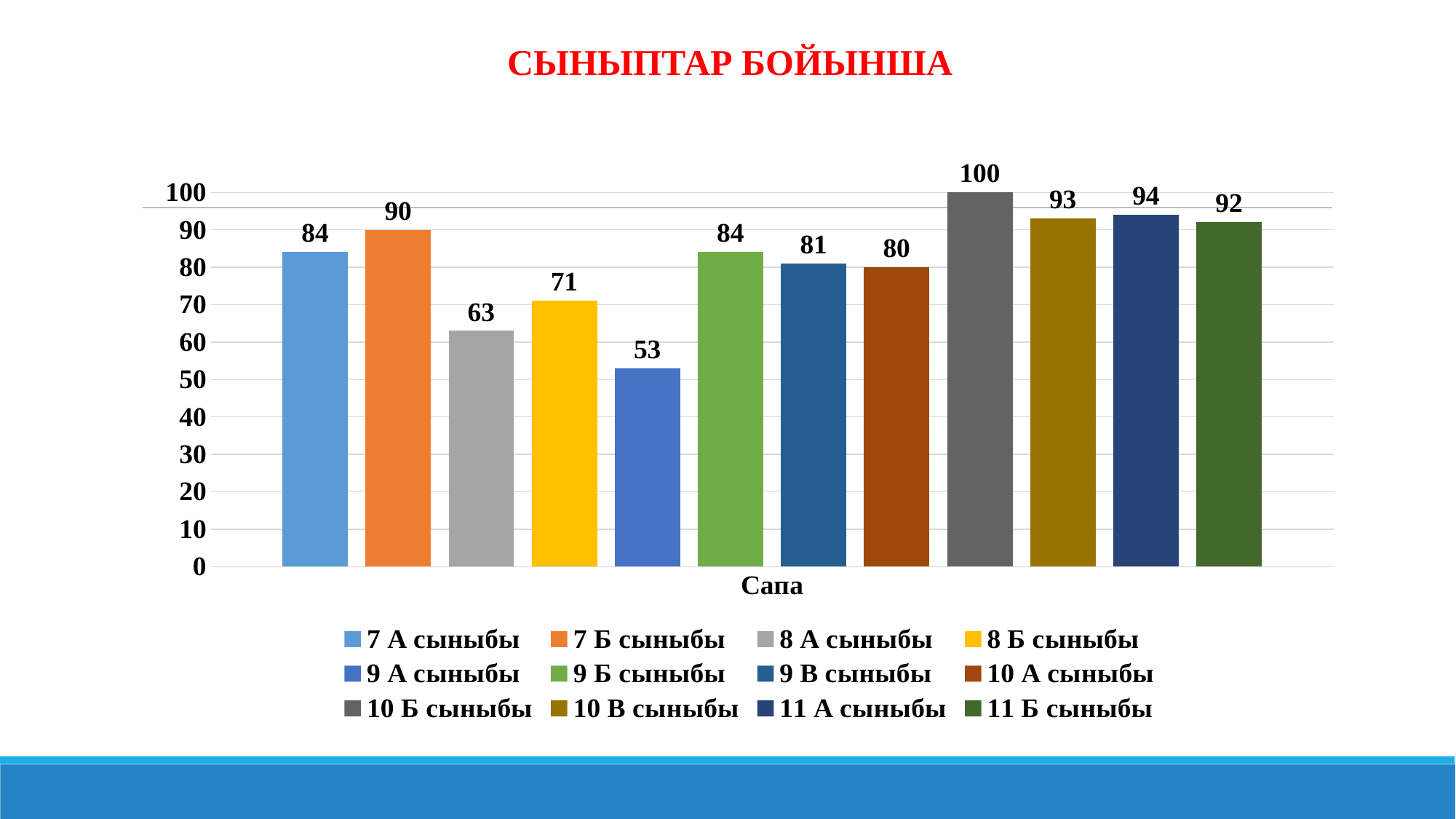
What is the value for 10 В сыныбы? 93 What is the label shown on the x axis? Сапа What kind of chart is shown on the slide? bar chart What is the value for 7 А сыныбы? 84 Which is larger, the value for 11 А сыныбы or the value for 11 Б сыныбы? 11 А сыныбы What is the title of the chart? СЫНЫПТАР БОЙЫНША How many series does the legend list? 12 What is the value for 9 А сыныбы? 53 Which series has the lowest value? 9 А сыныбы Is the value for 8 Б сыныбы greater or less than 80? less Which series has the highest value? 10 Б сыныбы What is the difference between the values for 7 Б сыныбы and 8 А сыныбы? 27